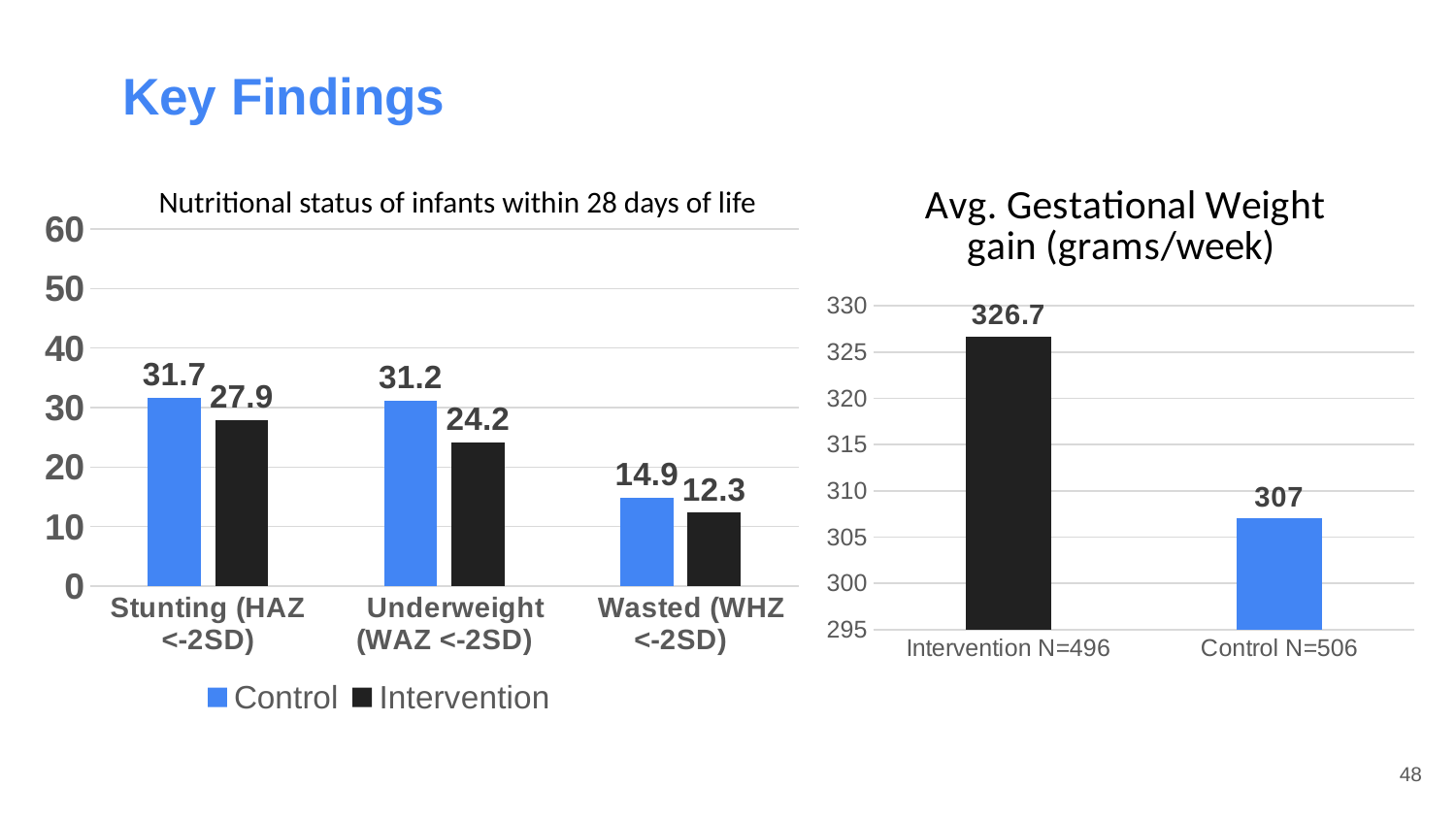
In the 'Nutritional status of infants within 28 days of life' chart, which colour represents the Intervention series? Black In the 'Nutritional status of infants within 28 days of life' chart, which is larger for Stunting (HAZ <-2SD): Control or Intervention? Control What type of chart is the 'Avg. Gestational Weight gain (grams/week)' chart? Bar chart How many categories are shown in the 'Nutritional status of infants within 28 days of life' chart? 3 In the 'Avg. Gestational Weight gain (grams/week)' chart, what is the value for Intervention N=496? 326.7 In the 'Nutritional status of infants within 28 days of life' chart, what is the Control value for Stunting (HAZ <-2SD)? 31.7 In the 'Nutritional status of infants within 28 days of life' chart, what is the difference between the Control and Intervention values for Underweight (WAZ <-2SD)? 7 In the 'Nutritional status of infants within 28 days of life' chart, what is the Intervention value for Wasted (WHZ <-2SD)? 12.3 In the 'Nutritional status of infants within 28 days of life' chart, what is the Intervention value for Underweight (WAZ <-2SD)? 24.2 In the 'Nutritional status of infants within 28 days of life' chart, which category has the lowest Control value? Wasted (WHZ <-2SD) How many series does the legend of the 'Nutritional status of infants within 28 days of life' chart list? 2 In the 'Avg. Gestational Weight gain (grams/week)' chart, what is the difference between Intervention N=496 and Control N=506? 19.7